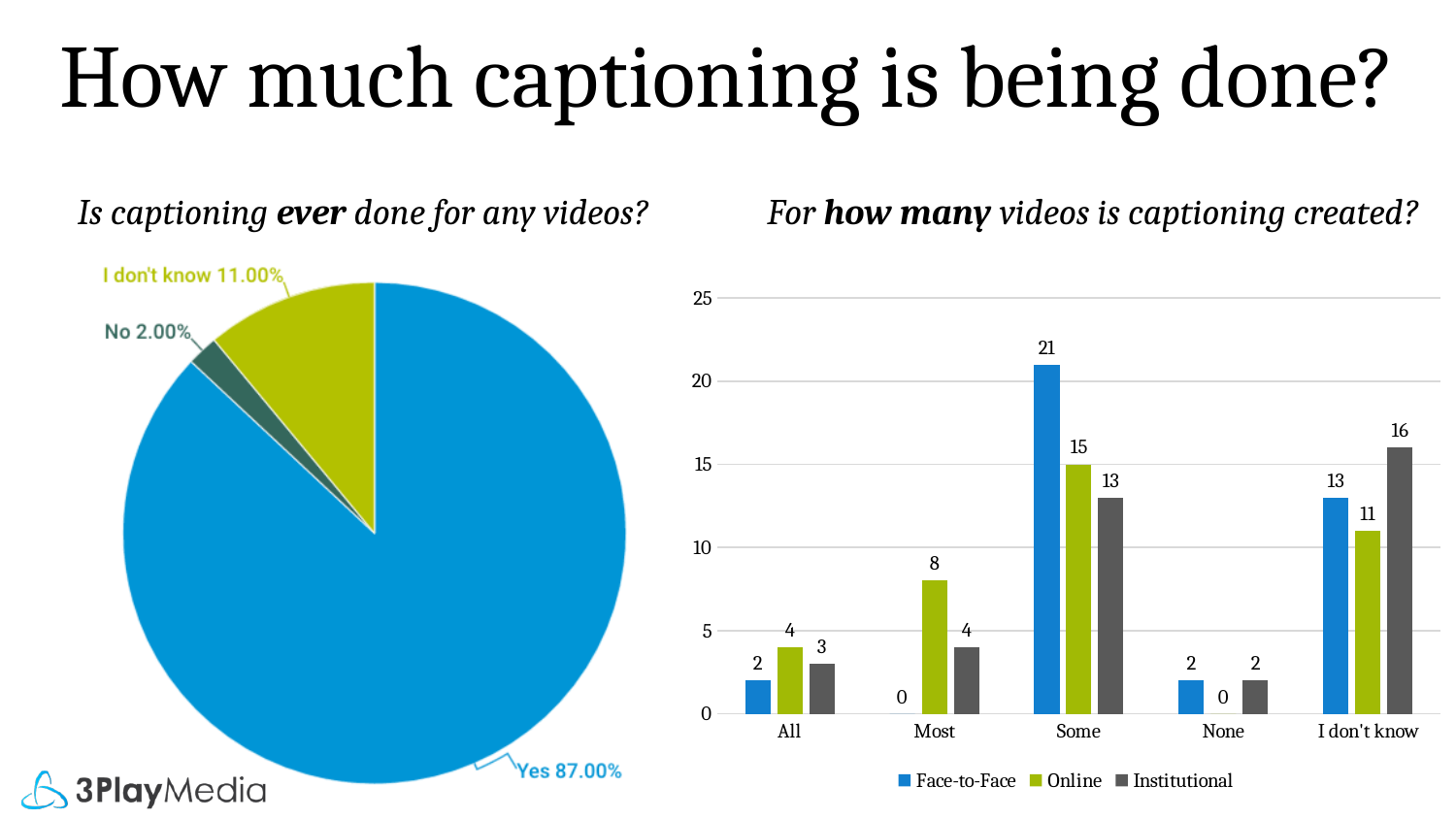
In the pie chart 'Is captioning ever done for any videos?', how many slices are there? 3 In the bar chart 'For how many videos is captioning created?', what is the Face-to-Face value for 'Some'? 21 In the pie chart 'Is captioning ever done for any videos?', what share is labelled 'I don't know'? 11.00% In the bar chart 'For how many videos is captioning created?', what is the difference between the Face-to-Face and Institutional values for 'Some'? 8 In the pie chart 'Is captioning ever done for any videos?', which slice is the smallest? No In the bar chart 'For how many videos is captioning created?', how many series does the legend list? 3 In the bar chart 'For how many videos is captioning created?', which category has the highest Online value? Some In the bar chart 'For how many videos is captioning created?', which is larger for 'I don't know': Face-to-Face or Online? Face-to-Face In the bar chart 'For how many videos is captioning created?', what is the Institutional value for 'I don't know'? 16 In the bar chart 'For how many videos is captioning created?', what is the Online value for 'Most'? 8 In the pie chart 'Is captioning ever done for any videos?', what share is labelled 'Yes'? 87.00% What type of chart is shown on the right side of the slide? Bar chart